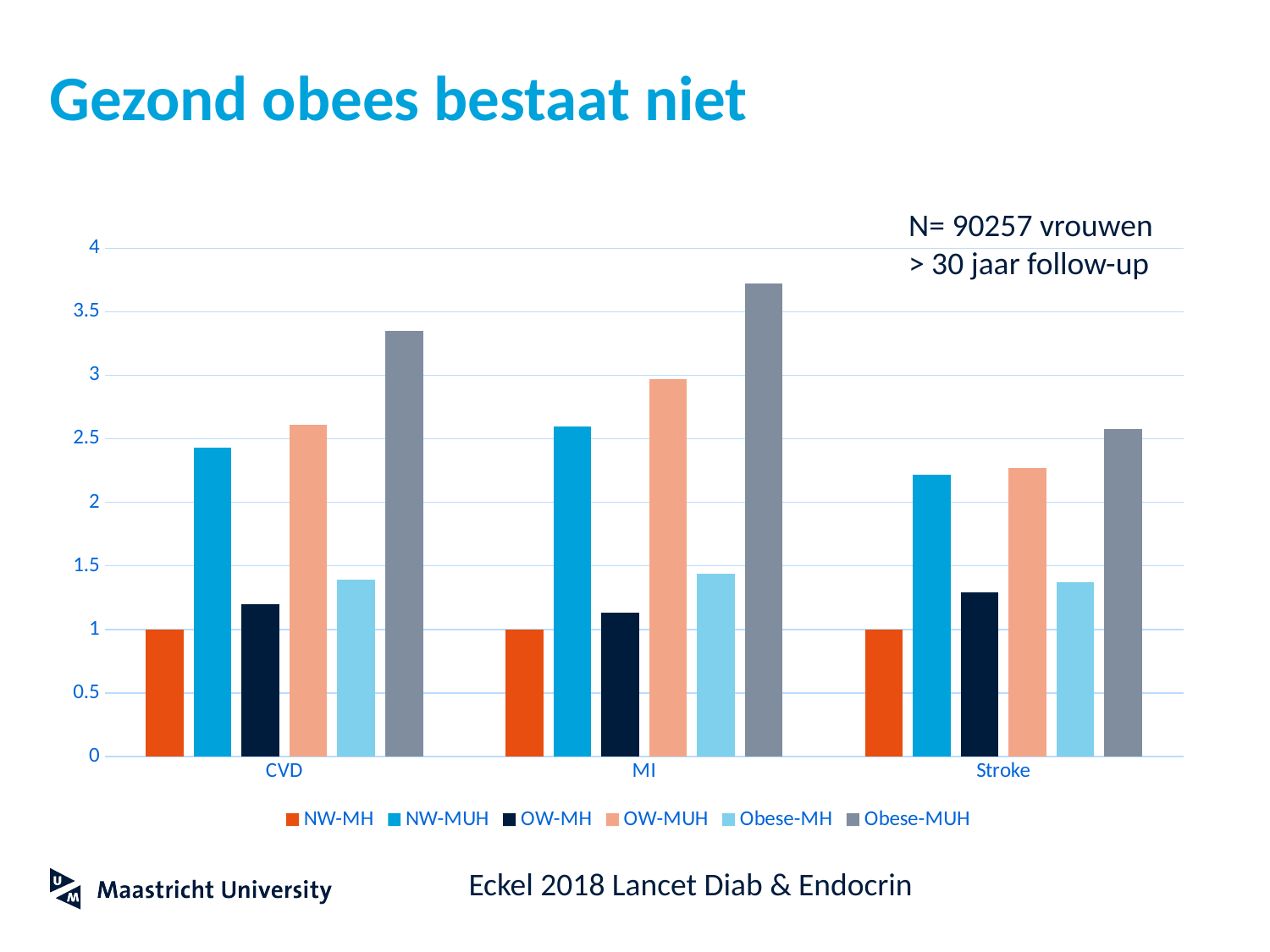
Which is larger: Obese-MUH for CVD or Obese-MUH for Stroke? CVD In which category is the Obese-MUH bar the highest? MI In the MI category, which is larger: NW-MUH or OW-MUH? OW-MUH What is the value for NW-MH in the Stroke category? 1 How many series does the chart legend list? 6 What kind of chart is shown on the slide? bar chart How many categories are shown on the x axis of the chart? 3 Is the value for Obese-MH in the CVD category greater or less than 1.5? less What is the value for NW-MH in the CVD category? 1 Is the value for Obese-MUH in the MI category greater or less than 3.5? greater Which series has the lowest value in the Stroke category? NW-MH What is the title of the slide containing the chart? Gezond obees bestaat niet